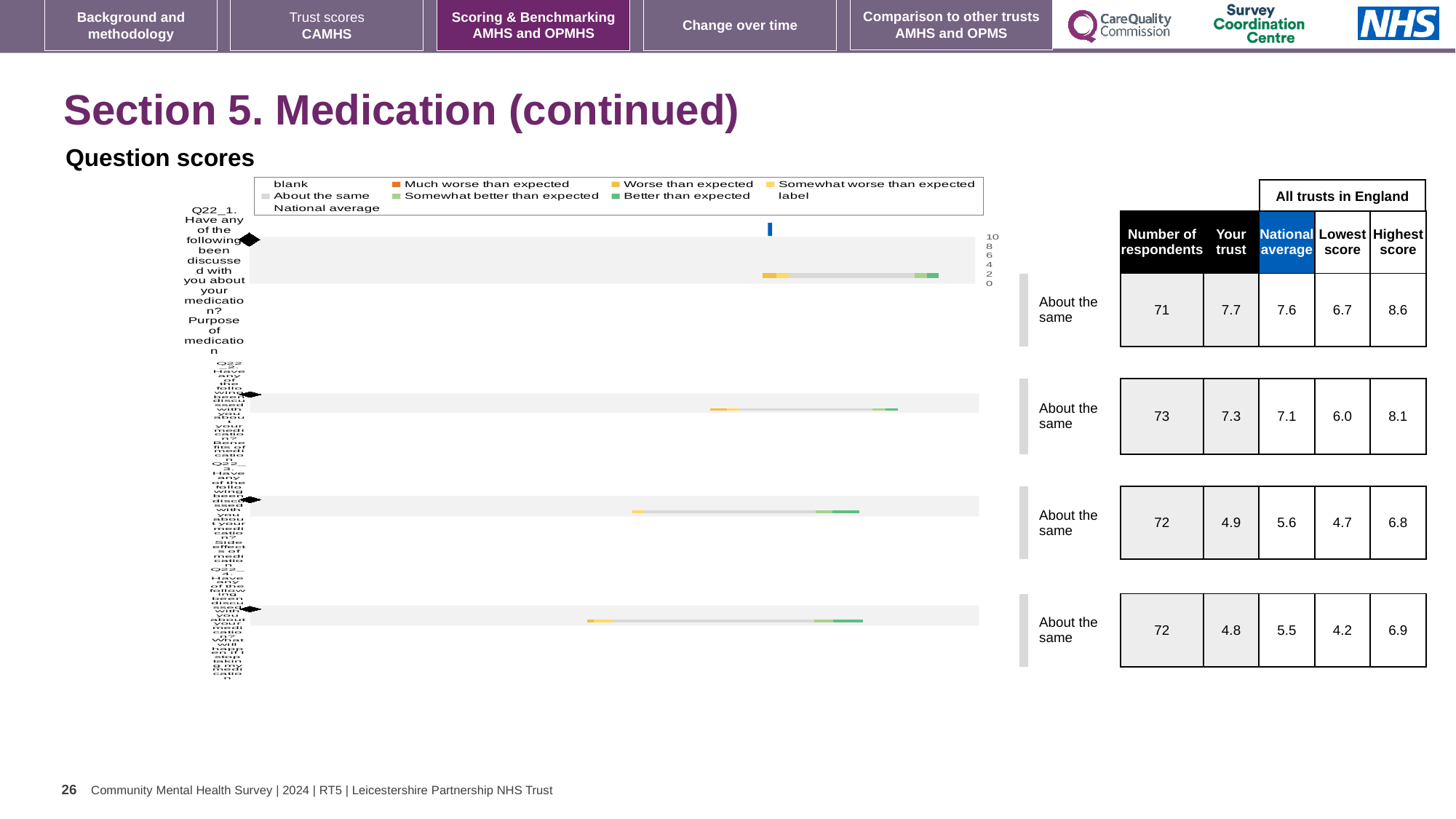
What is the 'Your trust' score for the first row (Q22_1, purpose of medication)? 7.7 Which question row has the highest 'Your trust' score? The first row (Q22_1, purpose of medication), 7.7 For the first question row, what is the difference between the highest score (8.6) and the lowest score (6.7)? 1.9 What is the lowest score among all trusts in England for the fourth question row? 4.2 How many respondents are listed for the second question row? 73 For the third question row, which is larger: the 'Your trust' score or the national average? National average (5.6) Which question row has the lowest 'Your trust' score? The fourth row, 4.8 What kind of chart is used to show the question scores on this slide? bar chart What is the heading above the chart? Question scores What is the national average for the third question row? 5.6 How many question bars (rows) are plotted in the question scores chart? 4 What benchmark category is shown next to each of the four question bars? About the same